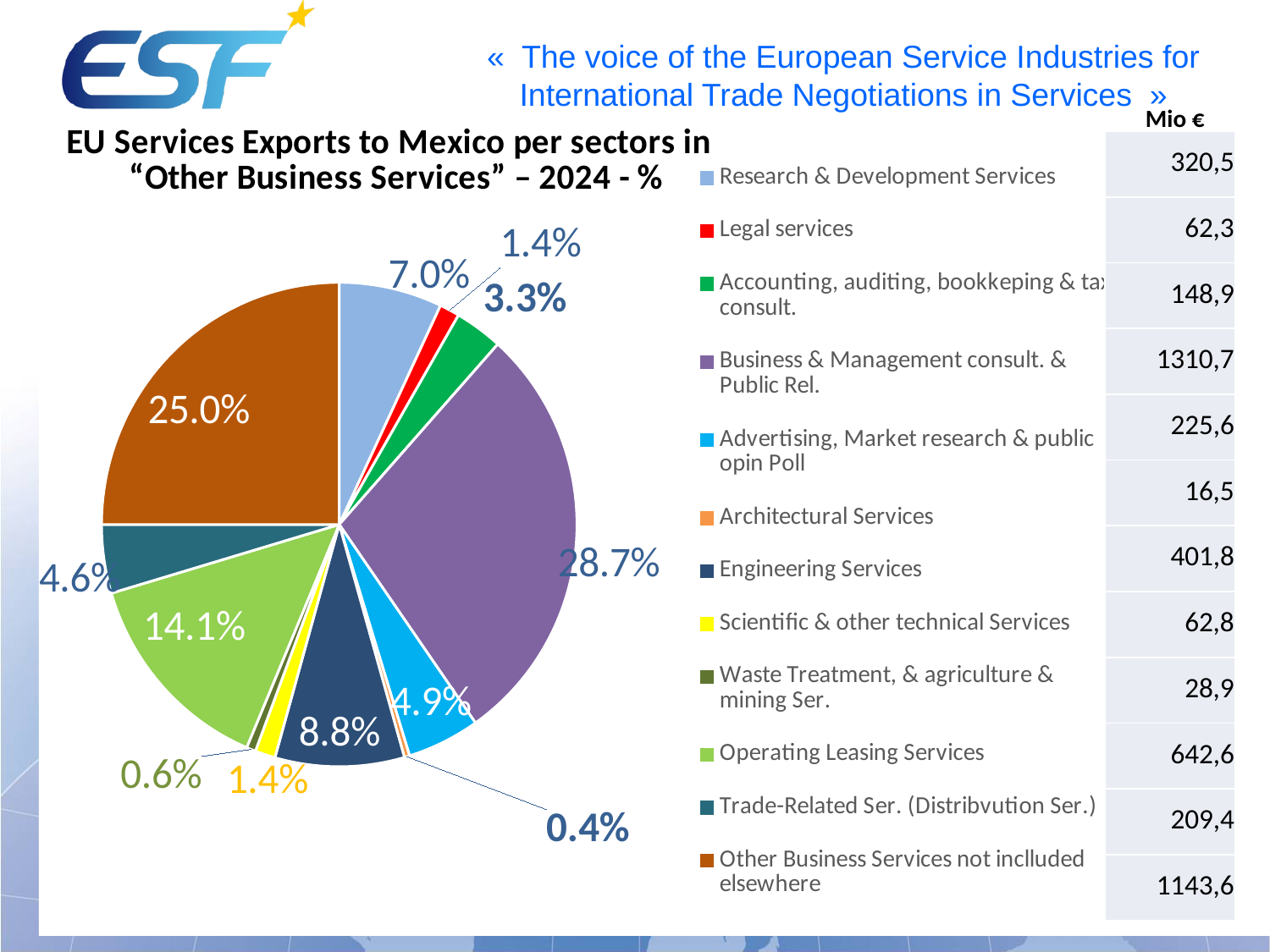
What share of the pie does Operating Leasing Services have? 14.1% What share of the pie does Other Business Services not included elsewhere have? 25.0% What is the value in Mio € for Business & Management consult. & Public Rel.? 1310,7 How many sectors does the legend of the pie chart list? 12 What kind of chart is shown on the slide? pie chart What is the value in Mio € for Architectural Services? 16,5 Which sector has the largest share of the pie chart? Business & Management consult. & Public Rel. What is the difference in percentage points between the share of Business & Management consult. & Public Rel. and the share of Other Business Services not included elsewhere? 3.7 Which has a larger share of the pie, Operating Leasing Services or Engineering Services? Operating Leasing Services Which sector has the smallest share of the pie chart? Architectural Services What is the title of the pie chart? EU Services Exports to Mexico per sectors in "Other Business Services" – 2024 - % What share of the pie does Engineering Services have? 8.8%